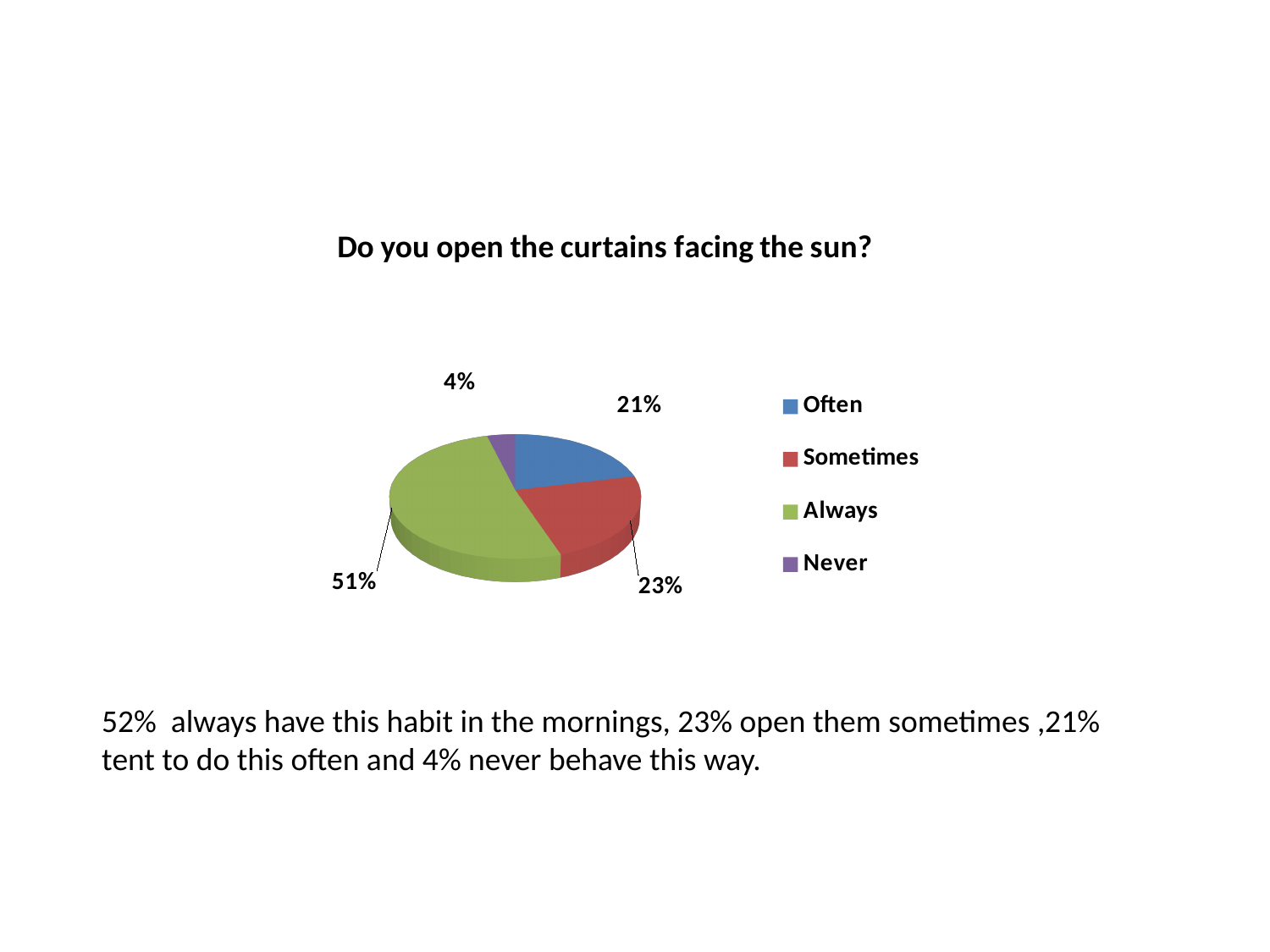
Which slice is larger, Sometimes or Often? Sometimes How many categories does the legend list? 4 Which category has the largest slice of the pie? Always Which category has the smallest slice of the pie? Never What percentage of the pie is labelled for Often? 21% What percentage of the pie is labelled for Always? 51% What colour is the Always slice in the pie chart? Green What percentage of the pie is labelled for Never? 4% What is the difference in percentage points between the Always slice and the Sometimes slice? 28 What is the chart's title? Do you open the curtains facing the sun? What percentage of the pie is labelled for Sometimes? 23% What type of chart is shown on the slide? Pie chart